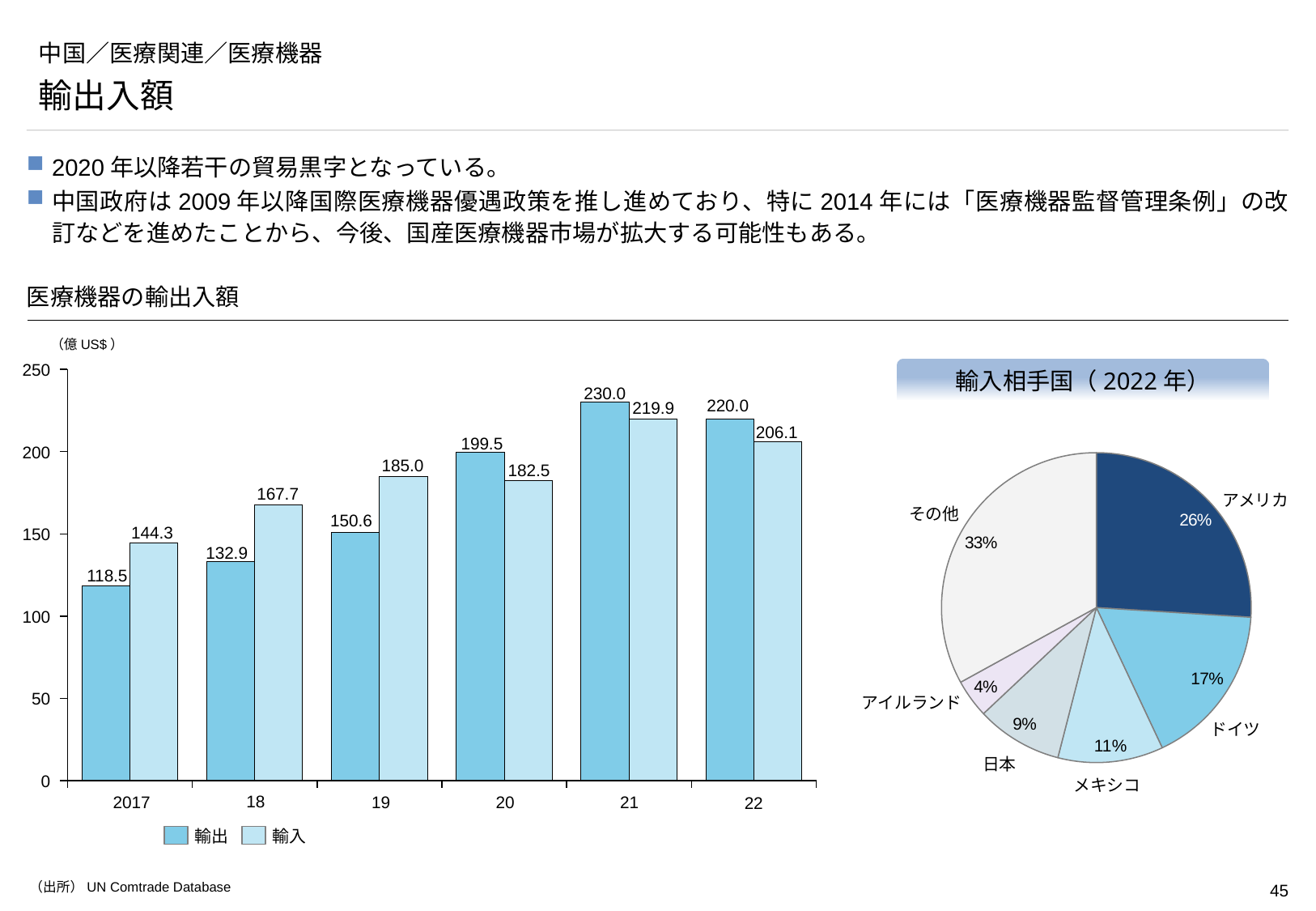
In the pie chart 輸入相手国（2022年）, how many slices are there? 6 In the bar chart 医療機器の輸出入額, which is larger in 19, 輸出 or 輸入? 輸入 In the bar chart 医療機器の輸出入額, what is the 輸入 value for 22? 206.1 In the bar chart 医療機器の輸出入額, what is the 輸出 value for 2017? 118.5 In the bar chart 医療機器の輸出入額, which year has the highest 輸出 value? 21 What kind of chart is 医療機器の輸出入額? bar chart In the bar chart 医療機器の輸出入額, which year has the lowest 輸入 value? 2017 In the pie chart 輸入相手国（2022年）, which named country has the smallest share? アイルランド In the bar chart 医療機器の輸出入額, what is the difference between 輸出 and 輸入 in 21? 10.1 In the bar chart 医療機器の輸出入額, how many years are shown on the x axis? 6 In the pie chart 輸入相手国（2022年）, what share does アメリカ have? 26% In the bar chart 医療機器の輸出入額, how many series does the legend list? 2